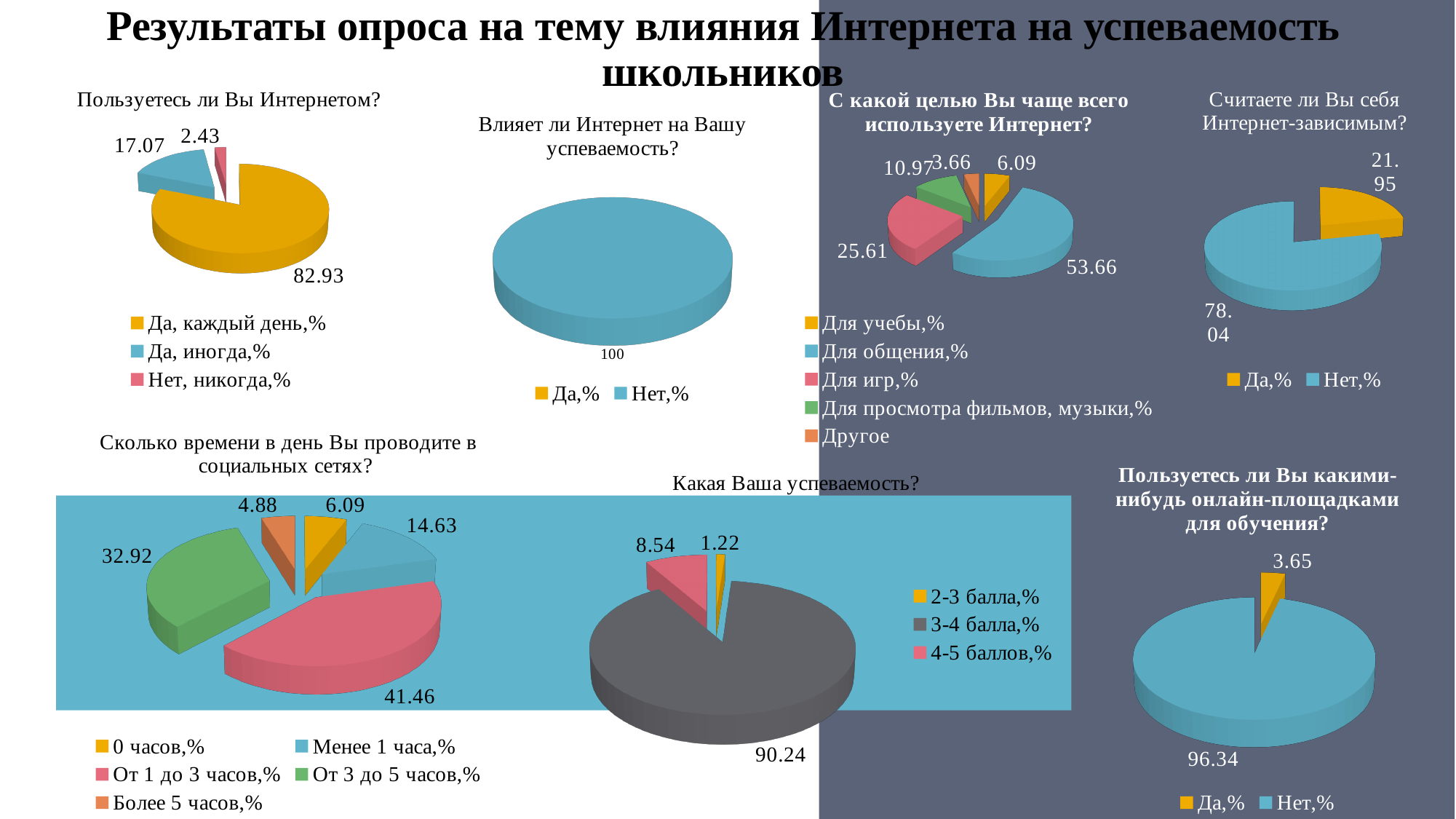
In the chart "С какой целью Вы чаще всего используете Интернет?", what is the value for "Для игр,%"? 25.61 In the chart "Пользуетесь ли Вы Интернетом?", what is the value for "Да, каждый день,%"? 82.93 What type of chart is "Какая Ваша успеваемость?"? Pie chart In the chart "Сколько времени в день Вы проводите в социальных сетях?", what is the value for "От 3 до 5 часов,%"? 32.92 In the chart "Считаете ли Вы себя Интернет-зависимым?", what is the value for "Да,%"? 21.95 In the chart "Пользуетесь ли Вы какими-нибудь онлайн-площадками для обучения?", what is the value for "Нет,%"? 96.34 In the chart "Какая Ваша успеваемость?", which is larger: "4-5 баллов,%" or "2-3 балла,%"? 4-5 баллов,% In the chart "Сколько времени в день Вы проводите в социальных сетях?", what is the difference between "От 1 до 3 часов,%" and "Менее 1 часа,%"? 26.83 How many categories does the legend of the chart "С какой целью Вы чаще всего используете Интернет?" list? 5 In the chart "Влияет ли Интернет на Вашу успеваемость?", what value is shown for the "Нет,%" slice? 100 In the chart "С какой целью Вы чаще всего используете Интернет?", which category has the highest value? Для общения,% In the chart "Пользуетесь ли Вы Интернетом?", which category has the lowest value? Нет, никогда,%